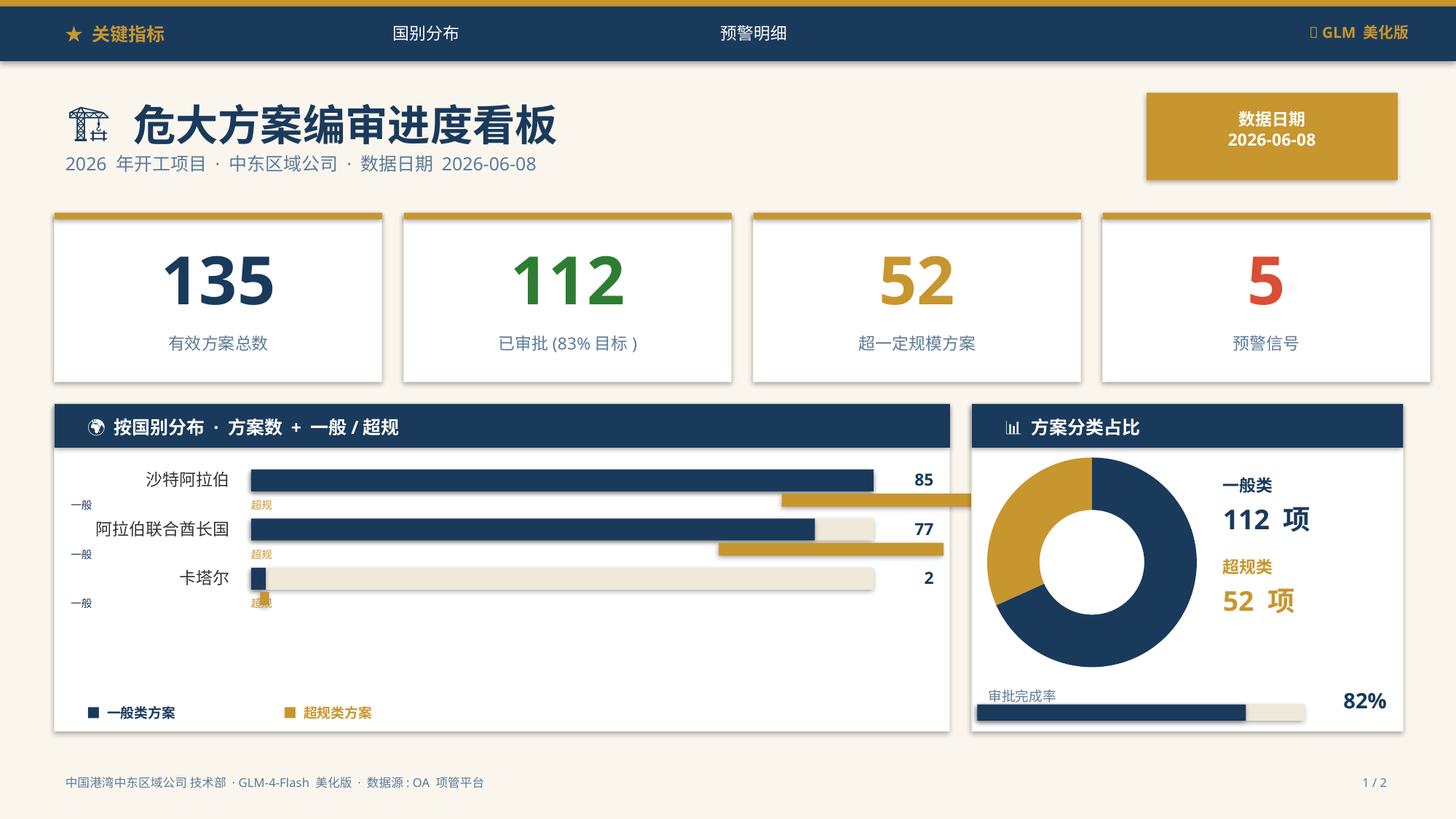
In the chart titled 按国别分布 · 方案数 + 一般 / 超规, which country has the highest value? 沙特阿拉伯 In the chart titled 按国别分布 · 方案数 + 一般 / 超规, what is the value for 沙特阿拉伯? 85 What kind of chart is the chart titled 按国别分布 · 方案数 + 一般 / 超规? bar chart In the chart titled 方案分类占比, which category is larger, 一般类 or 超规类? 一般类 How many countries are shown in the chart titled 按国别分布 · 方案数 + 一般 / 超规? 3 In the chart titled 按国别分布 · 方案数 + 一般 / 超规, which is larger, the value for 阿拉伯联合酋长国 or the value for 卡塔尔? 阿拉伯联合酋长国 In the chart titled 按国别分布 · 方案数 + 一般 / 超规, what is the value for 阿拉伯联合酋长国? 77 In the chart titled 按国别分布 · 方案数 + 一般 / 超规, what is the value for 卡塔尔? 2 How many series does the legend of the chart titled 按国别分布 · 方案数 + 一般 / 超规 list? 2 In the chart titled 按国别分布 · 方案数 + 一般 / 超规, which country has the lowest value? 卡塔尔 In the chart titled 方案分类占比, what is the value for 超规类? 52 项 In the chart titled 按国别分布 · 方案数 + 一般 / 超规, what is the difference between the values for 沙特阿拉伯 and 阿拉伯联合酋长国? 8